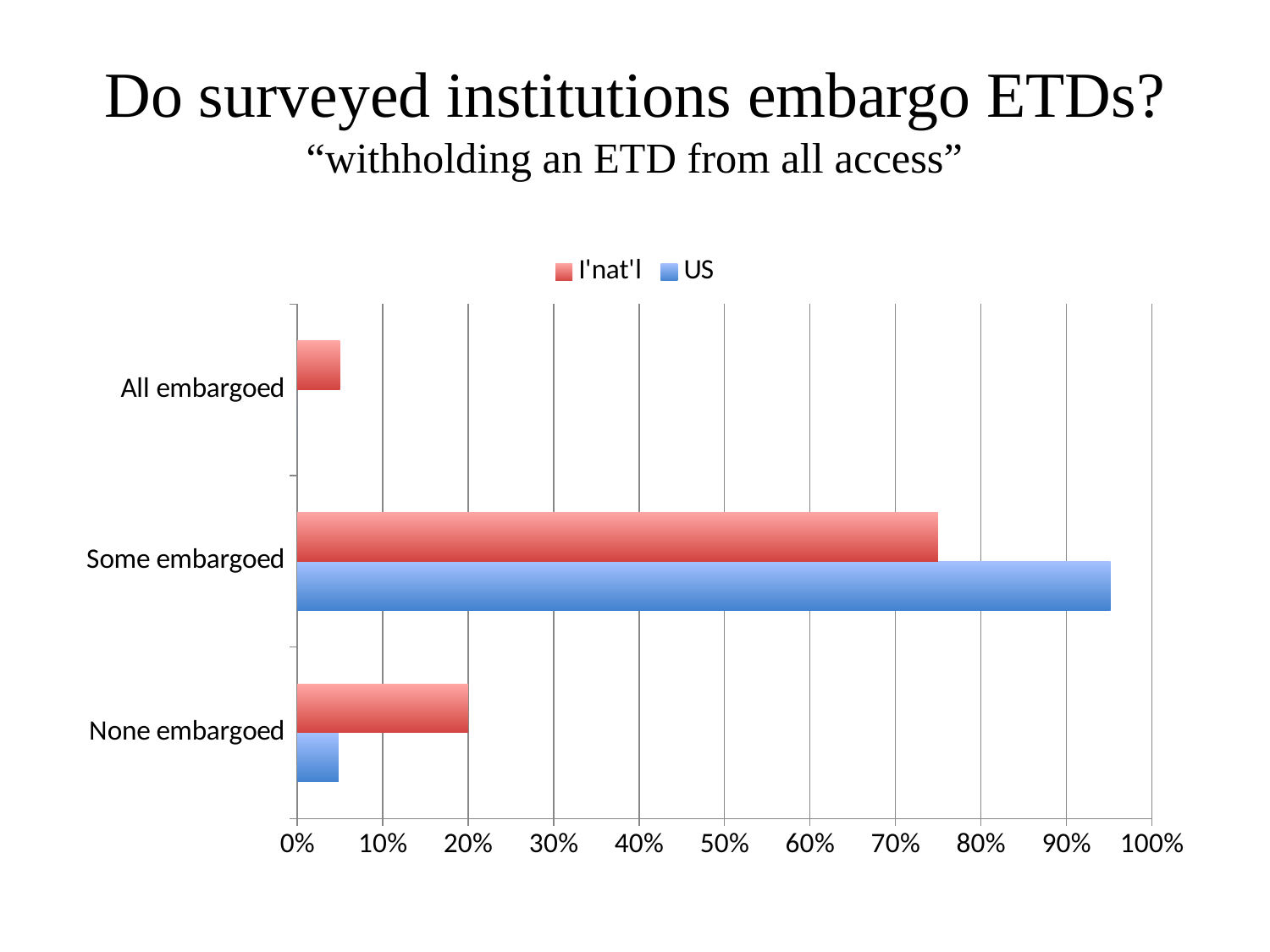
For None embargoed, which series has the larger value, I'nat'l or US? I'nat'l How many series does the legend list? 2 Which category has the highest value for the US series? Some embargoed For Some embargoed, which series has the larger value, I'nat'l or US? US Which category has the lowest value for the I'nat'l series? All embargoed Is the I'nat'l value for All embargoed greater or less than 10%? less How many categories are shown on the vertical axis? 3 Is the I'nat'l value for Some embargoed greater or less than 70%? greater What kind of chart is shown on the slide? bar chart Which category has the highest value for the I'nat'l series? Some embargoed Is the US value for Some embargoed greater or less than 90%? greater What are the two series named in the legend? I'nat'l and US